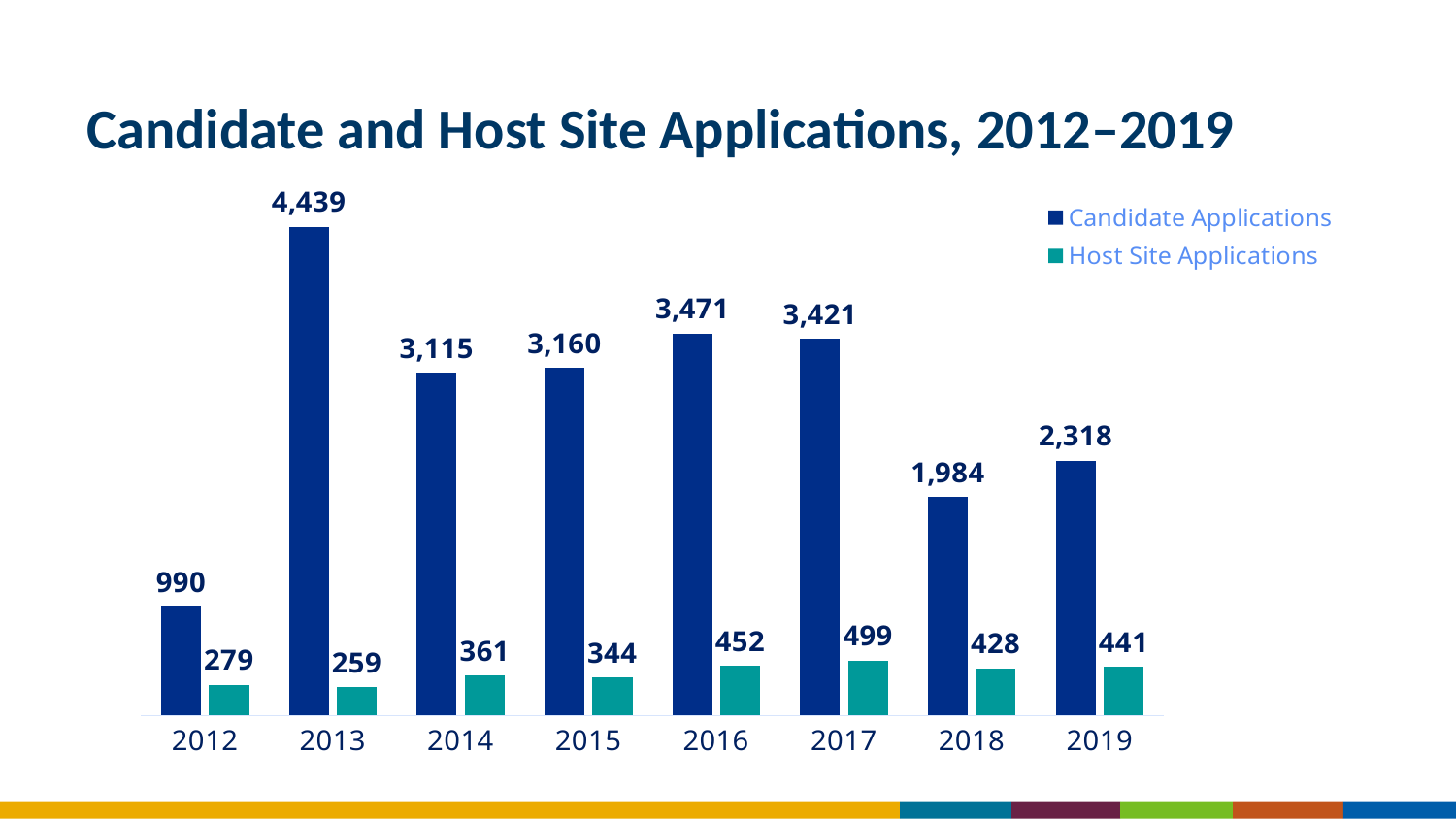
Which year had more Candidate Applications, 2018 or 2019? 2019 How many Host Site Applications were there in 2017? 499 Which year had the lowest number of Host Site Applications? 2013 How many series does the legend list? 2 How many years are shown on the x axis? 8 Did Candidate Applications rise or fall from 2017 to 2018? Fall What is the difference between Host Site Applications in 2016 and 2012? 173 What kind of chart is shown on the slide? Bar chart What is the difference between Candidate Applications in 2016 and 2017? 50 What is the title of the chart? Candidate and Host Site Applications, 2012-2019 Which year had the highest number of Candidate Applications? 2013 How many Candidate Applications were there in 2013? 4,439